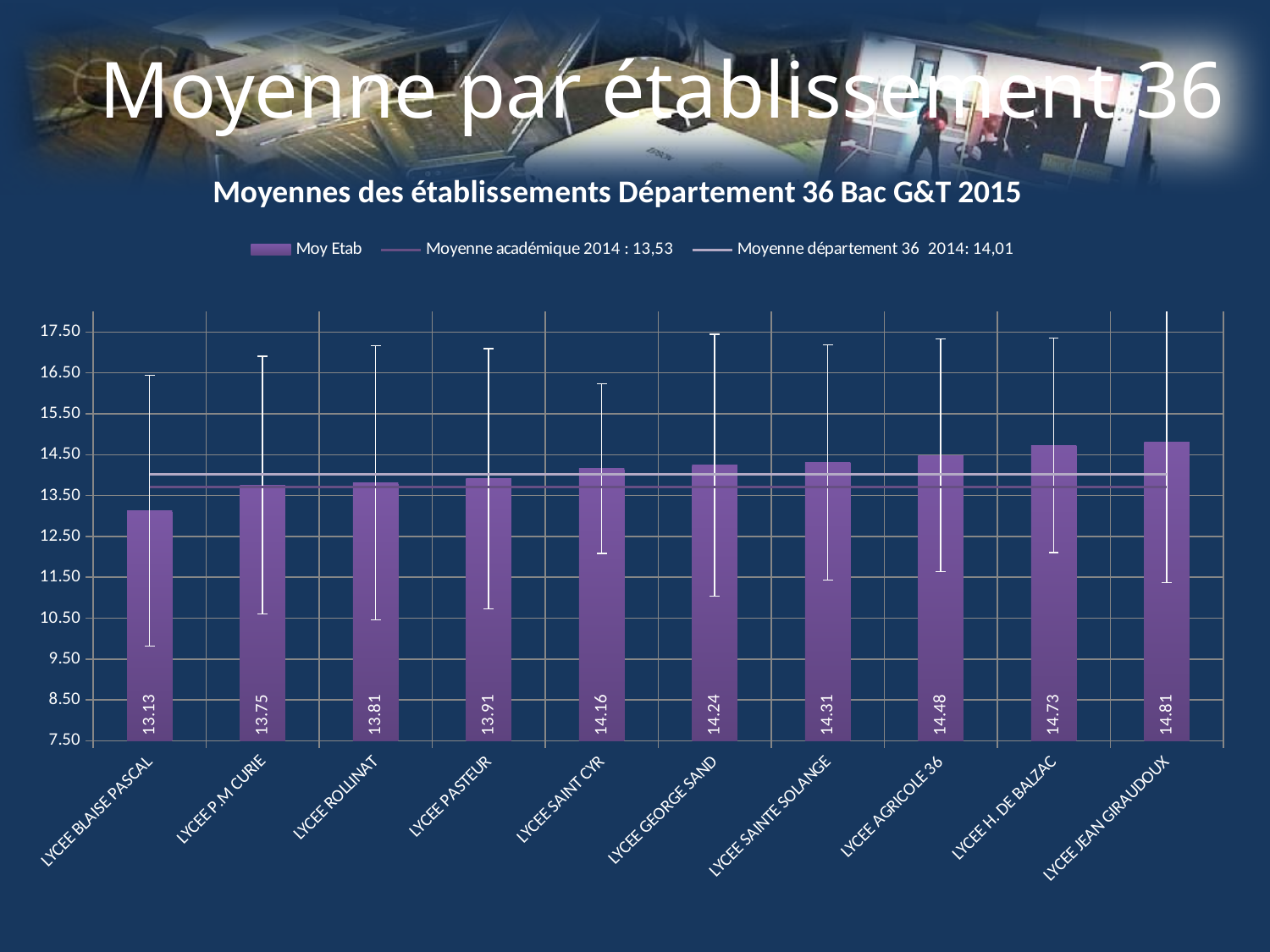
What kind of chart is shown? bar chart How many entries does the legend list? 3 How many establishments are shown on the x axis? 10 What is the value for LYCEE AGRICOLE 36? 14.48 Is the value for LYCEE SAINTE SOLANGE greater or less than 13.50? greater What is the difference between the values for LYCEE JEAN GIRAUDOUX and LYCEE BLAISE PASCAL? 1.68 Which is larger, the value for LYCEE H. DE BALZAC or the value for LYCEE GEORGE SAND? LYCEE H. DE BALZAC What is the value for LYCEE SAINT CYR? 14.16 Which establishment has the highest value? LYCEE JEAN GIRAUDOUX Which establishment has the lowest value? LYCEE BLAISE PASCAL What is the title of the chart? Moyennes des établissements Département 36 Bac G&T 2015 What is the value for LYCEE BLAISE PASCAL? 13.13